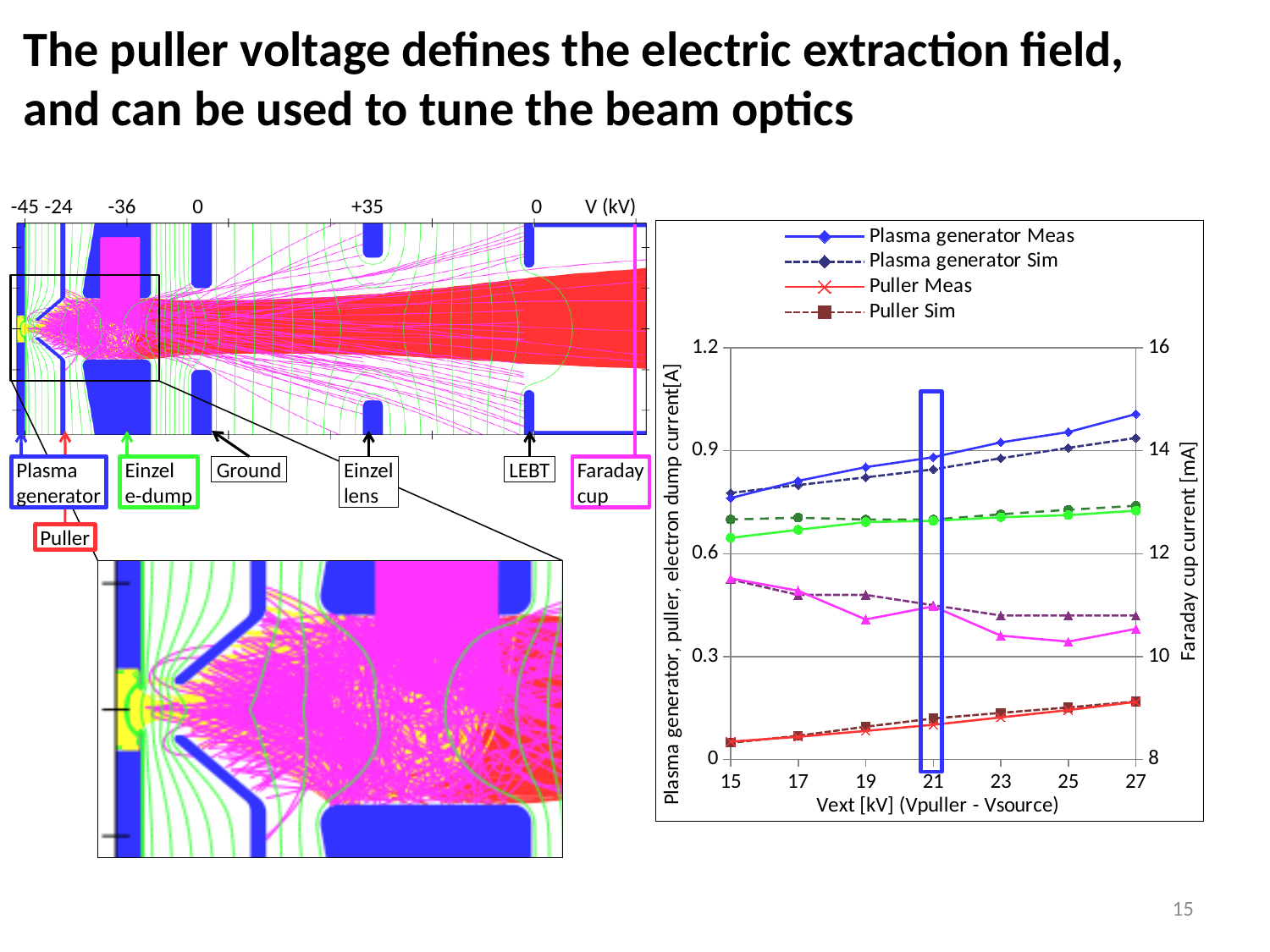
Is the Puller Meas value at Vext = 15 kV greater or less than 0.3 on the left axis? less At which Vext value is the Puller Meas series lowest? 15 What is the title of the right-hand y axis of the chart? Faraday cup current [mA] Is the Plasma generator Meas value at Vext = 27 kV greater or less than 0.9 on the left axis? greater At Vext = 21 kV, which is larger: the Plasma generator Meas value or the Puller Meas value? Plasma generator Meas What kind of chart is shown on the right side of the slide? line chart At which Vext value is the Plasma generator Meas series highest? 27 How many Vext values are marked along the x axis of the chart? 7 How many series does the legend of the chart list? 4 What is the x-axis title of the chart? Vext [kV] (Vpuller - Vsource) Does the Plasma generator Meas series rise or fall as Vext increases from 15 to 27 kV? rises Does the Puller Meas series rise or fall as Vext increases along the x axis? rises